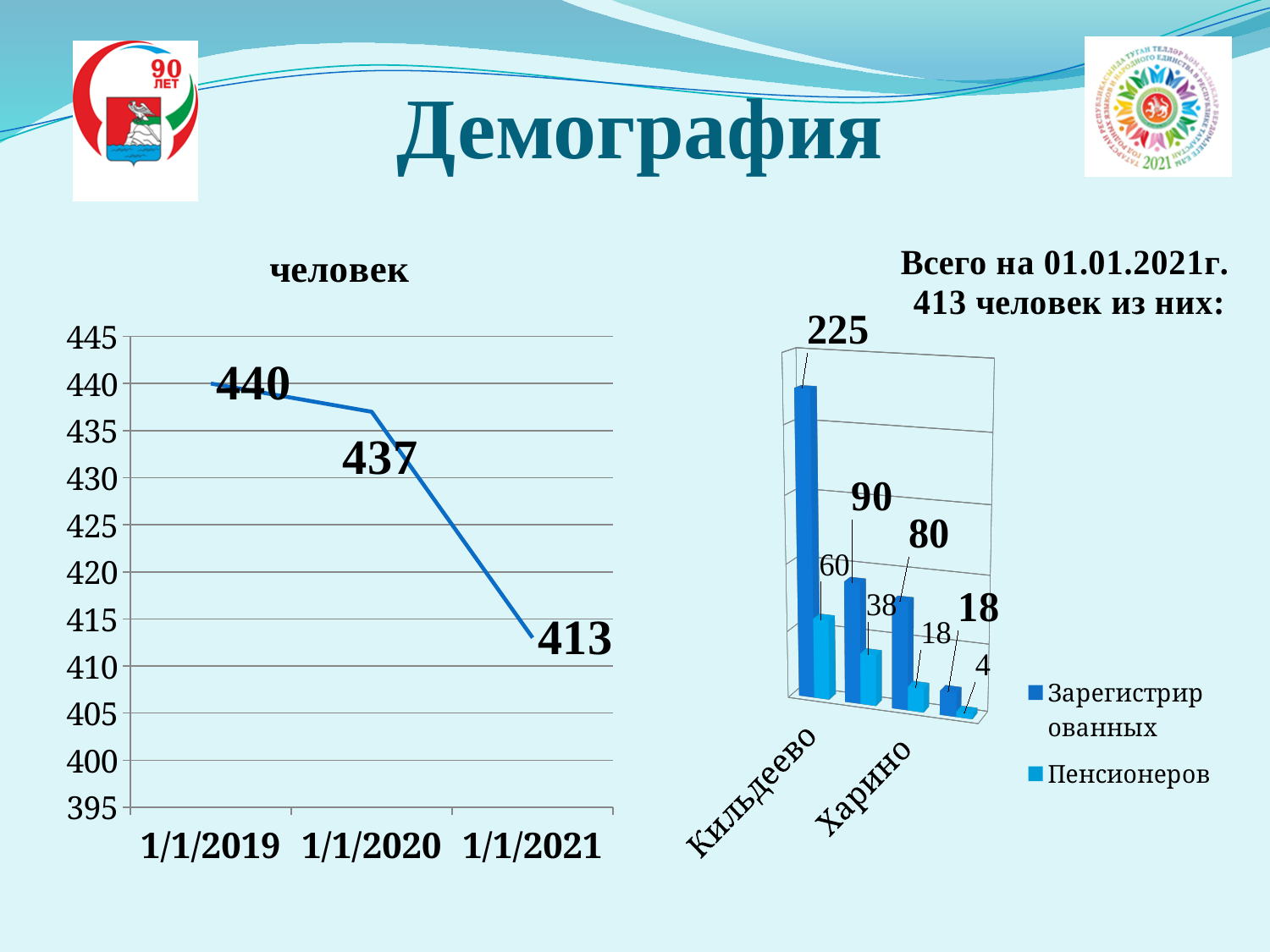
On the line chart titled "человек", what is the value for 1/1/2019? 440 What kind of chart is the chart on the left of the slide? line chart On the bar chart on the right, what is the value of Зарегистрированных for Кильдеево? 225 On the line chart titled "человек", what is the value for 1/1/2021? 413 On the bar chart on the right, how many series does the legend list? 2 On the line chart titled "человек", what is the value for 1/1/2020? 437 On the bar chart on the right, what is the value of Пенсионеров for Харино? 18 On the line chart titled "человек", by how much did the value fall from 1/1/2019 to 1/1/2021? 27 On the bar chart on the right, what is the difference between Зарегистрированных and Пенсионеров for Кильдеево? 165 On the line chart titled "человек", do the values rise or fall from 1/1/2019 to 1/1/2021? fall On the line chart titled "человек", how many data points are plotted? 3 On the bar chart on the right, which category has the highest value of Зарегистрированных? Кильдеево